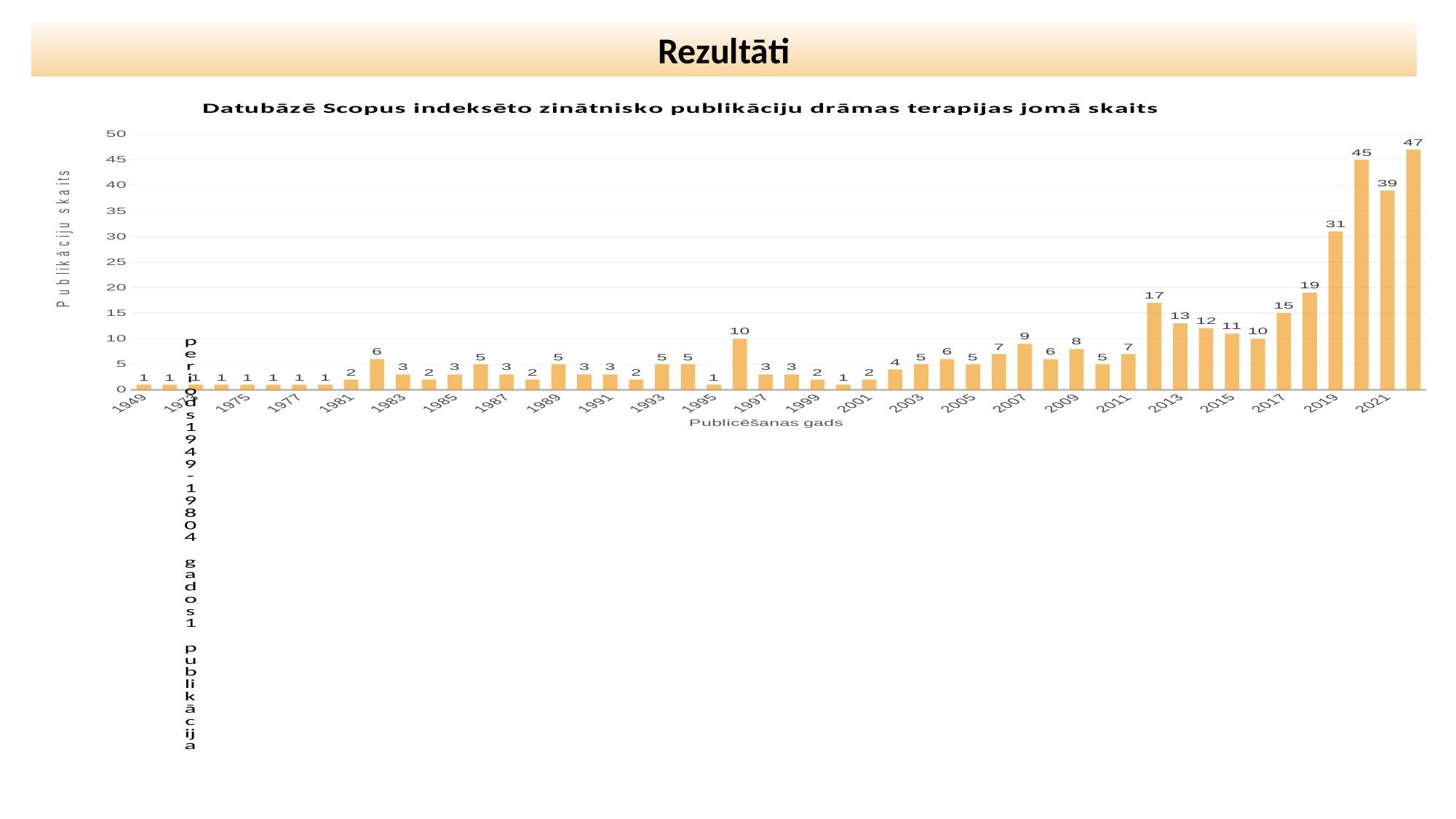
How many publications are shown for 2007? 9 How many publications are shown for 2017? 15 What is the difference between the values for 2021 and 2019? 8 How many publications are shown for 2019? 31 What is the label of the vertical axis? Publikāciju skaits Do the values generally rise or fall from the left of the x axis to the right? rise How many publications are shown for 2021? 39 What is the title of the chart? Datubāzē Scopus indeksēto zinātnisko publikāciju drāmas terapijas jomā skaits How many publications are shown for 2013? 13 What kind of chart is shown on the slide? bar chart What is the highest value shown on the chart? 47 Which year has the larger value, 2013 or 2017? 2017